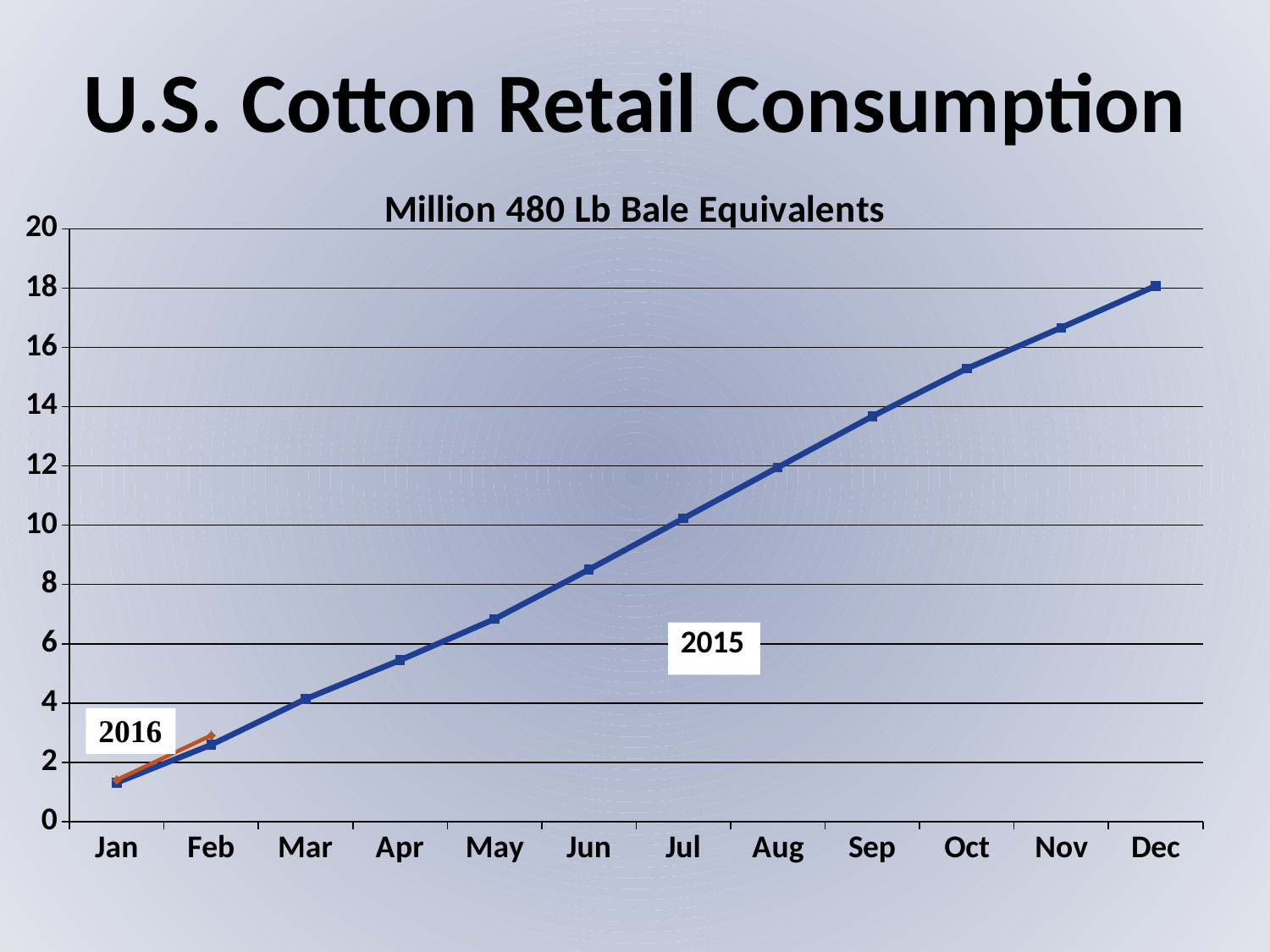
Is the 2015 value for Sep greater or less than 14? less How many data series are plotted on the chart? 2 Is the 2015 value for Jan greater or less than 2? less What is the title printed above the chart's plot area? Million 480 Lb Bale Equivalents Is the 2015 value for Dec greater or less than 16? greater What kind of chart is shown on the slide? line chart In which month does the 2015 series reach its highest value? Dec Which year's series is drawn in orange? 2016 Does the 2015 line rise or fall from Jan to Dec? rises In which month is the 2015 series at its lowest value? Jan How many months are shown along the x axis? 12